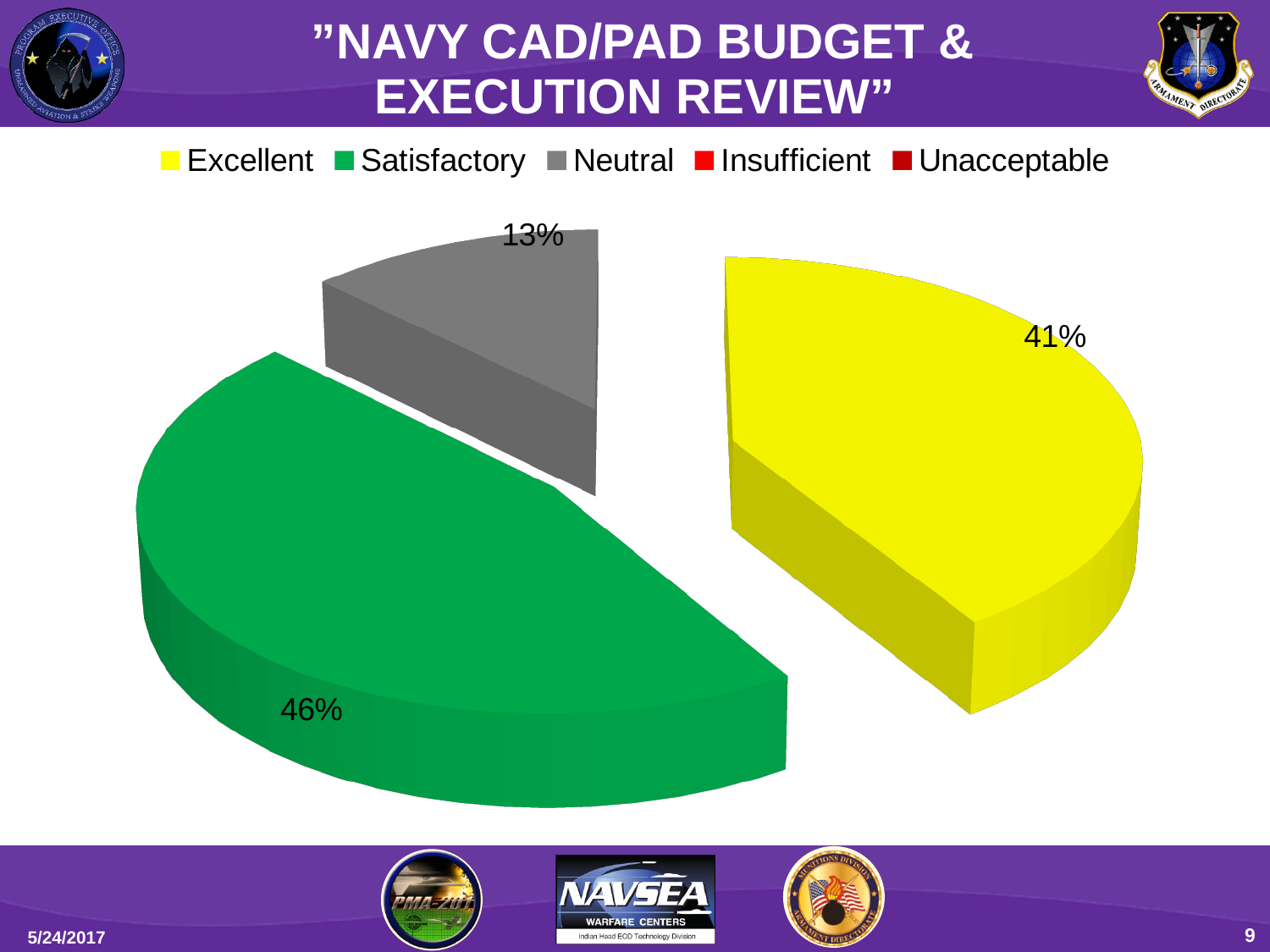
What percentage of the pie is Neutral? 13% What is the difference in percentage points between Excellent and Neutral? 28 What is the title of the chart? "NAVY CAD/PAD BUDGET & EXECUTION REVIEW" What is the difference in percentage points between Satisfactory and Excellent? 5 What percentage of the pie is Satisfactory? 46% What colour is the Satisfactory slice? Green Which of the visible slices has the smallest share of the pie? Neutral Which category has the largest share of the pie? Satisfactory What kind of chart is shown on the slide? Pie chart How many categories does the legend list? 5 Which is larger, the Excellent slice or the Neutral slice? Excellent What percentage of the pie is Excellent? 41%